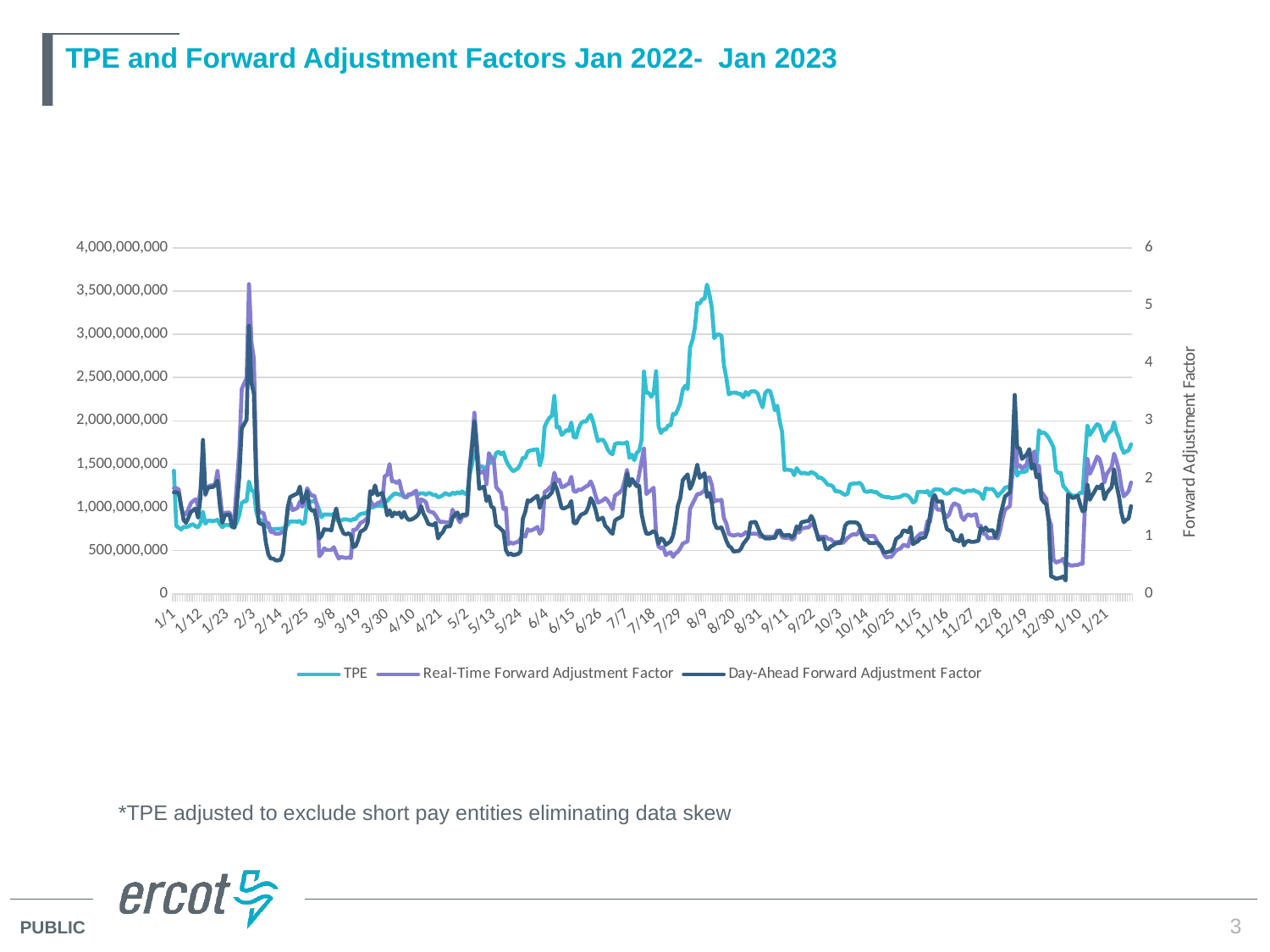
Is the value of TPE around 2/14 greater or less than 1,000,000,000? less Around 12/30, which is higher: the Real-Time Forward Adjustment Factor or the Day-Ahead Forward Adjustment Factor? Real-Time Forward Adjustment Factor Is the value of TPE around 9/22 greater or less than 1,000,000,000? greater How many series does the legend list? 3 Does TPE rise or fall between 8/9 and 9/22? fall Is the Day-Ahead Forward Adjustment Factor around 12/30 greater or less than 1 on the right axis? less What kind of chart is shown on the slide? Line chart Does TPE rise or fall overall between 6/4 and 8/9? rise What is the title of the chart? TPE and Forward Adjustment Factors Jan 2022- Jan 2023 What is the label on the right-hand vertical axis? Forward Adjustment Factor